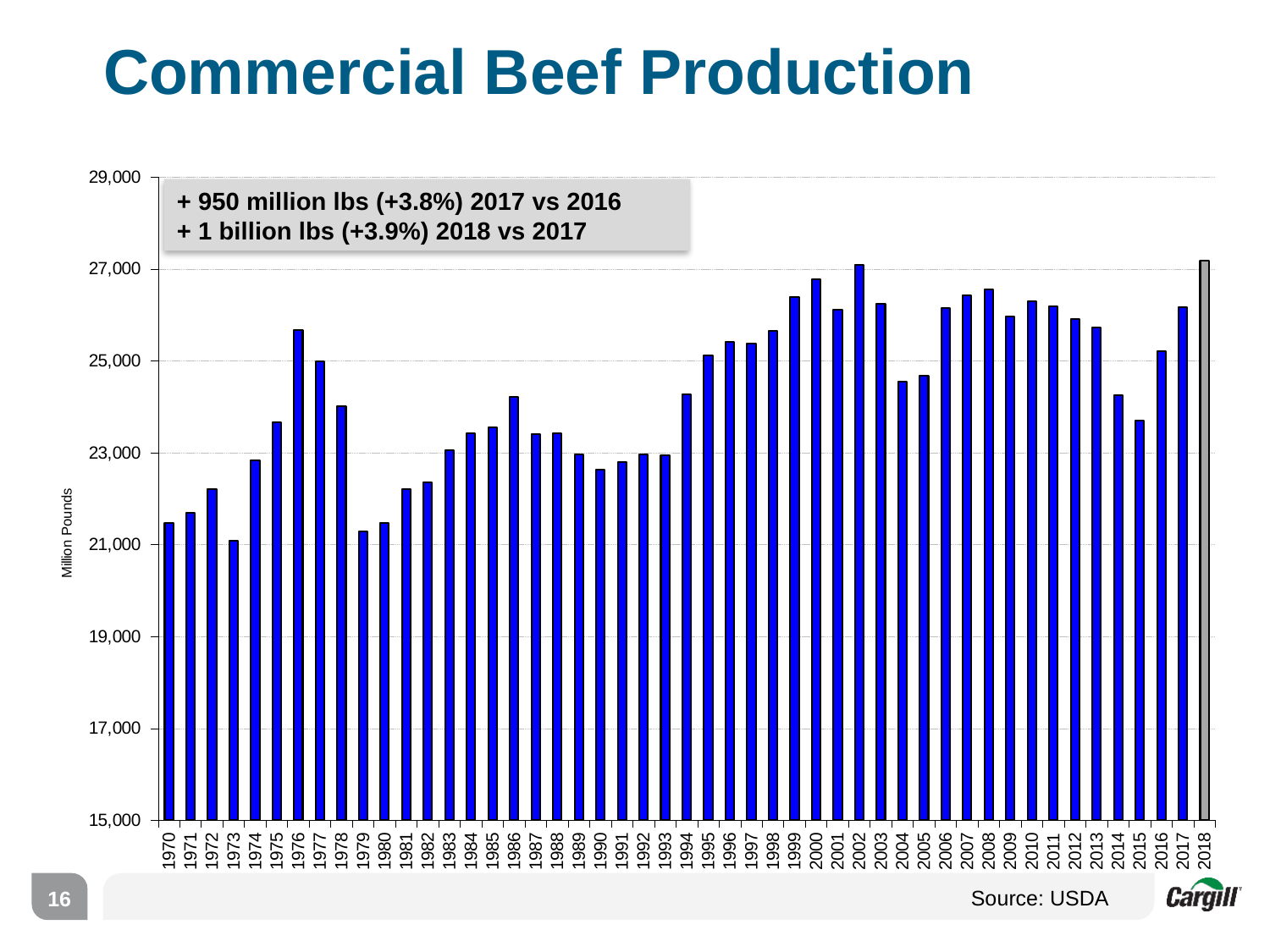
What is the label on the y axis of the chart? Million Pounds Is the value for 1973 greater or less than 23,000? less According to the annotation on the chart, by how much did production increase in 2017 vs 2016? + 950 million lbs (+3.8%) Which year has the larger value, 2016 or 2017? 2017 Is the value for 1976 greater or less than 25,000? greater What kind of chart is shown on the slide? Bar chart Do the values rise or fall from 1970 to 1976? rise Is the value for 1990 greater or less than 23,000? less How many years are plotted on the x axis of the Commercial Beef Production chart? 49 Which year has the larger value, 1975 or 1976? 1976